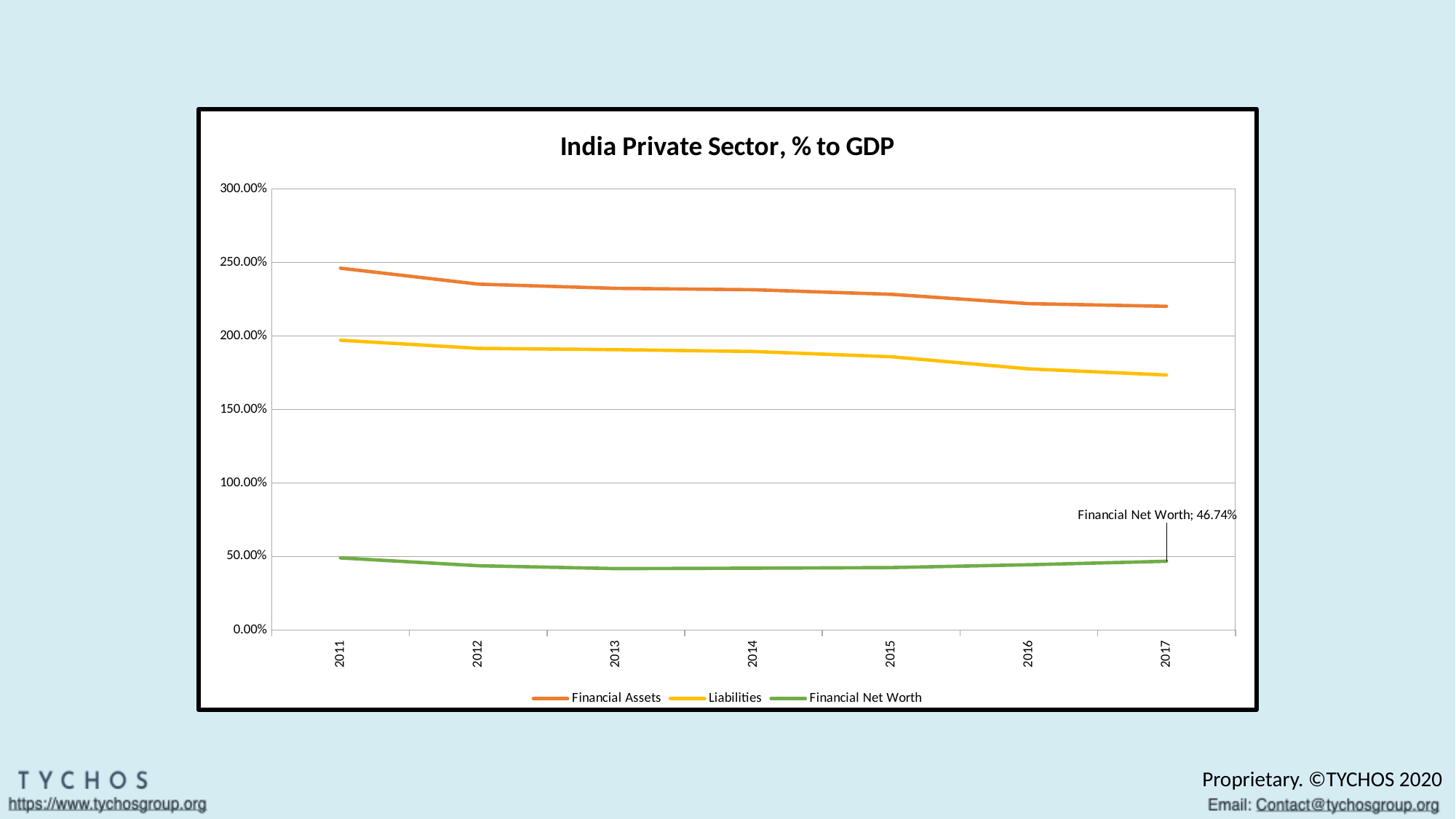
Which series has the highest values across all years? Financial Assets How many series does the legend list? 3 How many years are plotted along the x axis? 7 Which is larger in 2015, Financial Assets or Liabilities? Financial Assets Is the value for Financial Net Worth in 2013 greater or less than 50.00%? less Which series has the lowest values across all years? Financial Net Worth What kind of chart is shown on the slide? line chart Is the value for Liabilities in 2017 greater or less than 200.00%? less What is the value of Financial Net Worth in 2017? 46.74% Do the Financial Assets values rise or fall from 2011 to 2017? fall What is the title of the chart? India Private Sector, % to GDP Is the value for Financial Assets in 2011 greater or less than 200.00%? greater